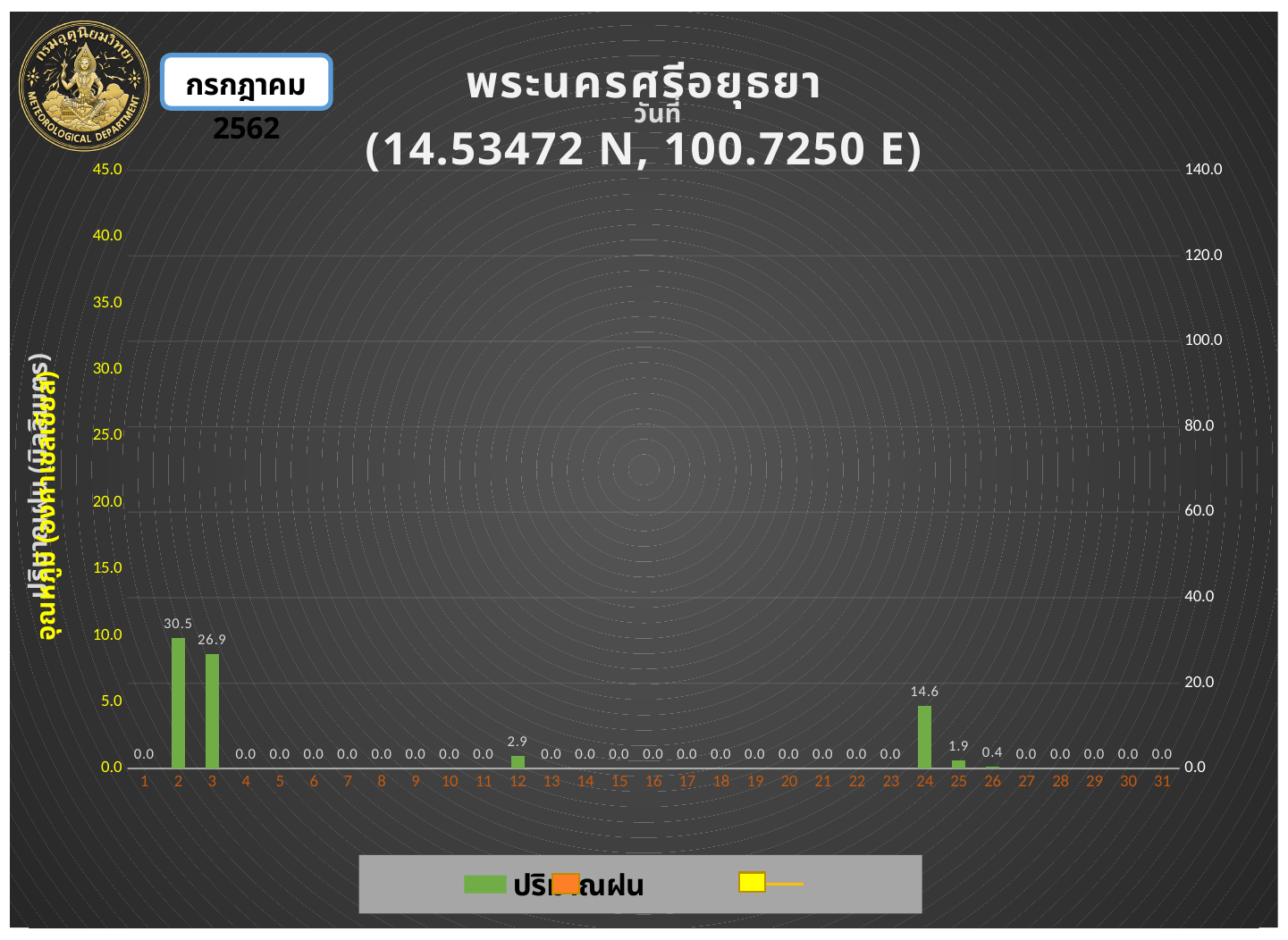
What is the rainfall value shown for day 12? 2.9 What is the difference between the rainfall values for day 24 and day 25? 12.7 What colour are the rainfall bars? green How many days are shown on the x axis? 31 Which day has the highest rainfall value? 2 What is the rainfall value shown for day 2? 30.5 What is the rainfall value shown for day 24? 14.6 What is the difference between the rainfall values for day 2 and day 3? 3.6 What kind of chart is used to show the rainfall values? bar chart What is the rainfall value shown for day 26? 0.4 What is the rainfall value shown for day 3? 26.9 Which is larger, the rainfall value for day 3 or for day 24? day 3